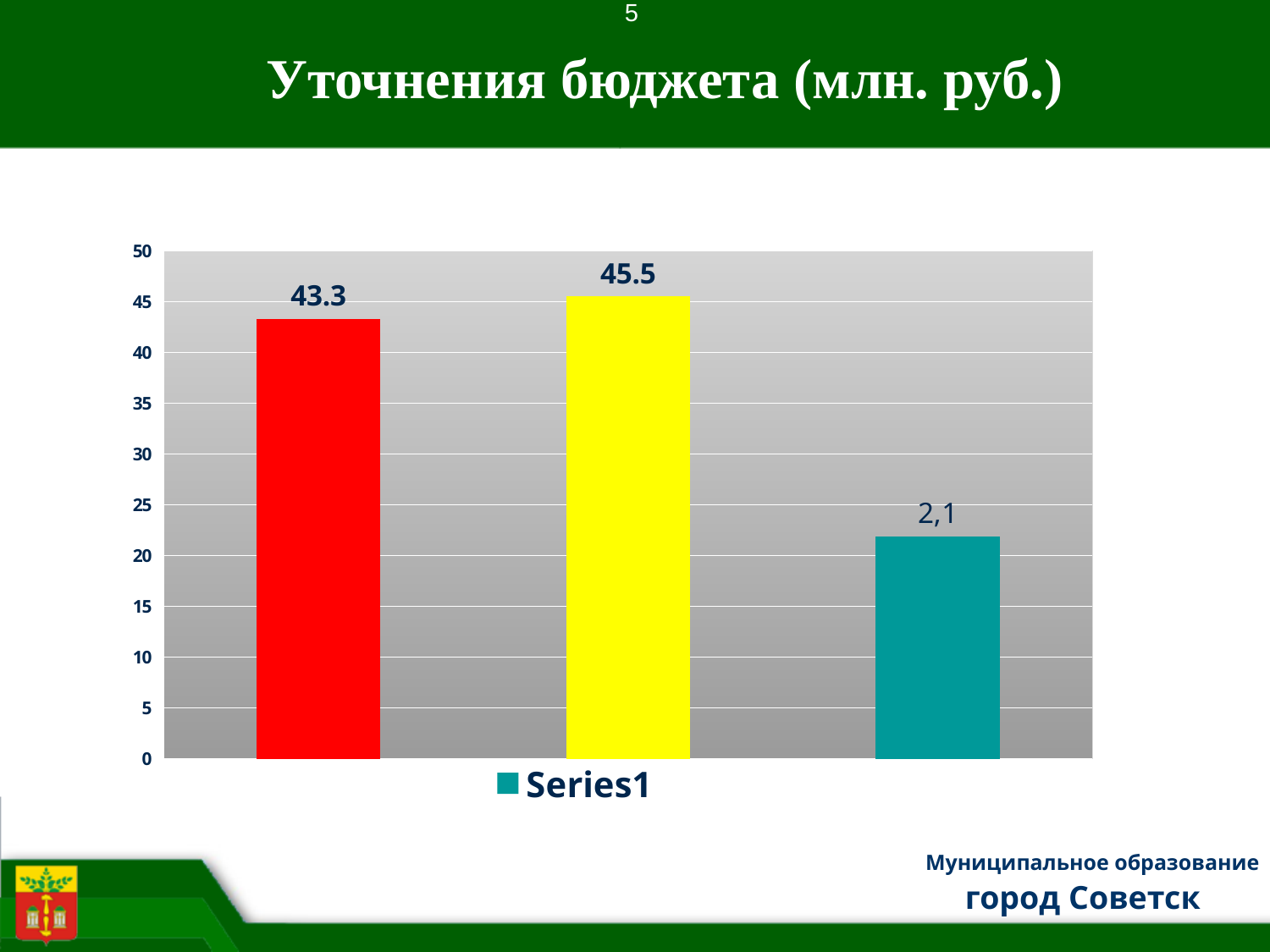
What is the legend entry shown below the chart? Series1 What is the difference between the yellow bar's value and the red bar's value? 2.2 What is the value shown on the red (leftmost) bar? 43.3 What is the title of the slide containing the chart? Уточнения бюджета (млн. руб.) Is the value for the red (leftmost) bar greater or less than 40? greater Which bar has the highest value? the yellow (middle) bar What kind of chart is shown on the slide? bar chart How many bars are plotted in the chart? 3 Which is larger, the value of the red bar or the value of the yellow bar? the yellow bar What is the value shown on the yellow (middle) bar? 45.5 How many series does the legend list? 1 Which bar has the lowest value? the teal (rightmost) bar